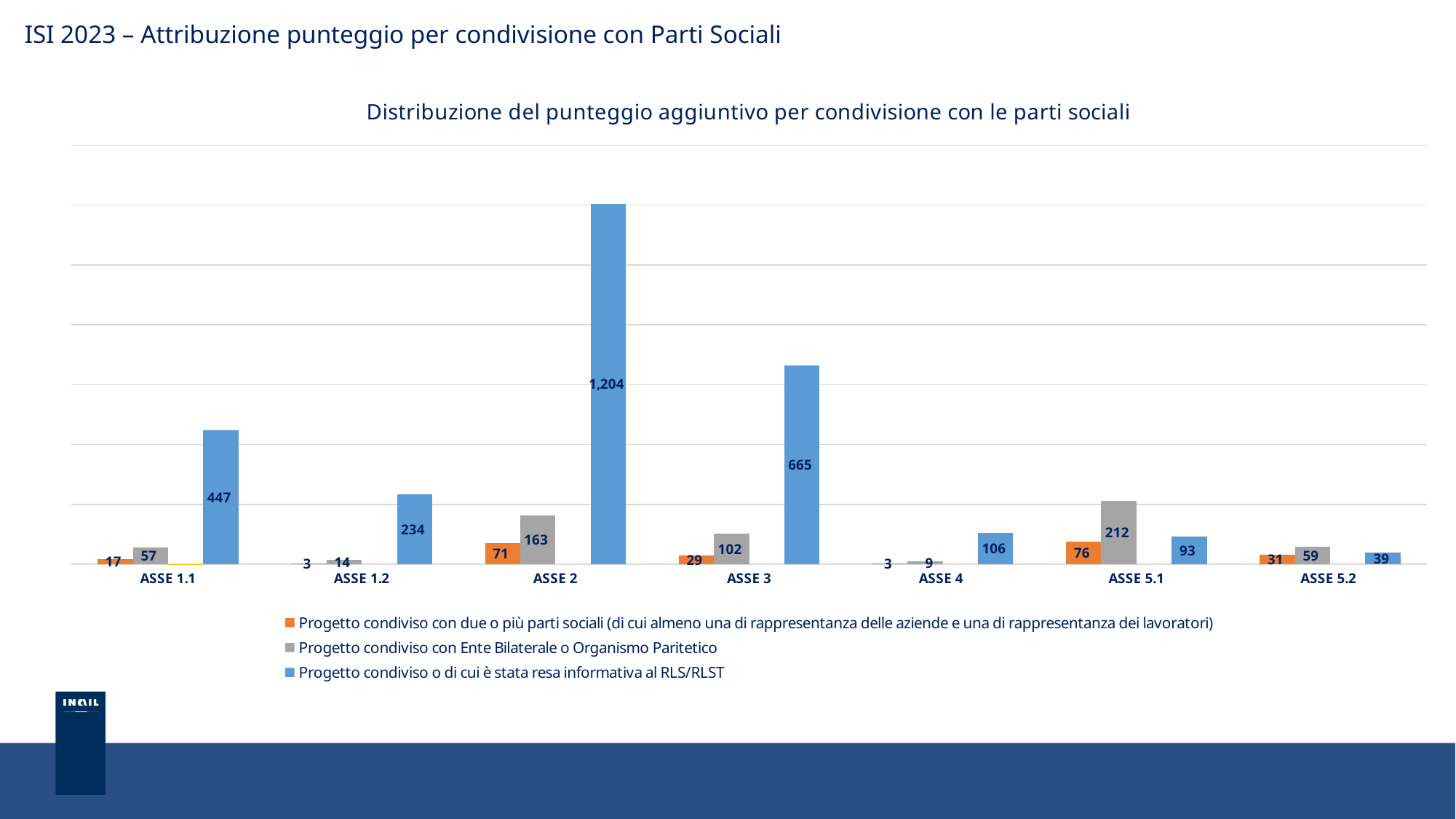
How many series does the legend list? 3 Which category has the lowest value in the series 'Progetto condiviso con Ente Bilaterale o Organismo Paritetico'? ASSE 4 What kind of chart is shown on the slide? Bar chart What is the difference between the RLS/RLST values for ASSE 2 and ASSE 3? 539 Which category has the highest value in the series 'Progetto condiviso o di cui è stata resa informativa al RLS/RLST'? ASSE 2 Which is larger: the 'Progetto condiviso con Ente Bilaterale o Organismo Paritetico' value for ASSE 5.1 or for ASSE 2? ASSE 5.1 How many categories are shown on the x axis? 7 What is the value for ASSE 5.1 in the series 'Progetto condiviso con Ente Bilaterale o Organismo Paritetico'? 212 What colour represents the series 'Progetto condiviso con due o più parti sociali'? Orange What is the value for ASSE 3 in the series 'Progetto condiviso con due o più parti sociali'? 29 What is the value for ASSE 2 in the series 'Progetto condiviso o di cui è stata resa informativa al RLS/RLST'? 1,204 What is the title of the chart? Distribuzione del punteggio aggiuntivo per condivisione con le parti sociali